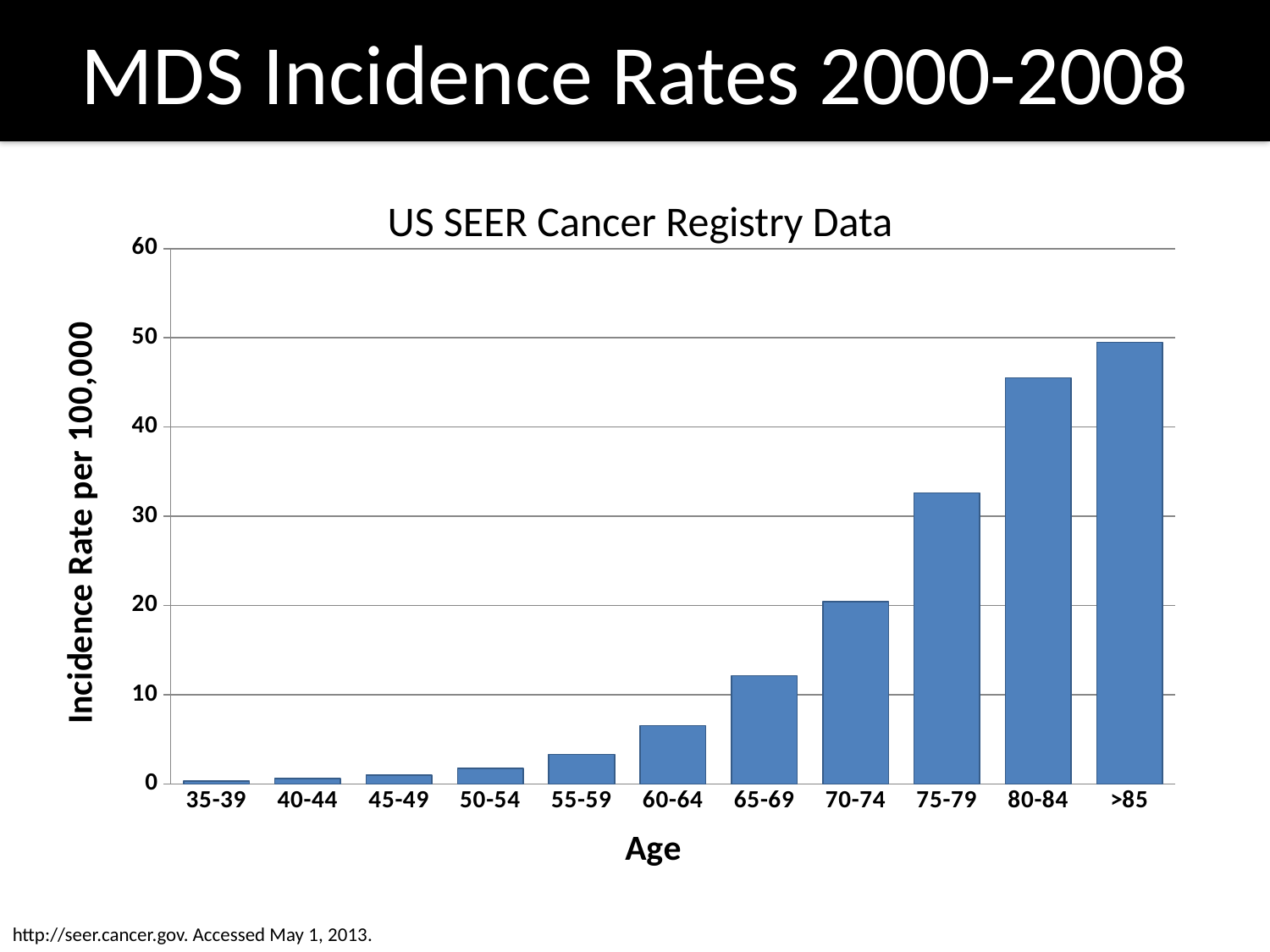
Is the incidence rate for the 80-84 age group greater or less than 40? greater Is the incidence rate for the 65-69 age group greater or less than 10? greater Is the incidence rate for the 60-64 age group greater or less than 10? less Which age group has the lowest incidence rate? 35-39 Do the incidence rates rise or fall as age increases along the x axis? rise Which age group has the highest incidence rate? >85 Which age group has a higher incidence rate, 70-74 or 75-79? 75-79 What is the title of the chart? US SEER Cancer Registry Data What is the label of the y axis? Incidence Rate per 100,000 What kind of chart is shown on the slide? bar chart How many age categories are plotted on the x axis? 11